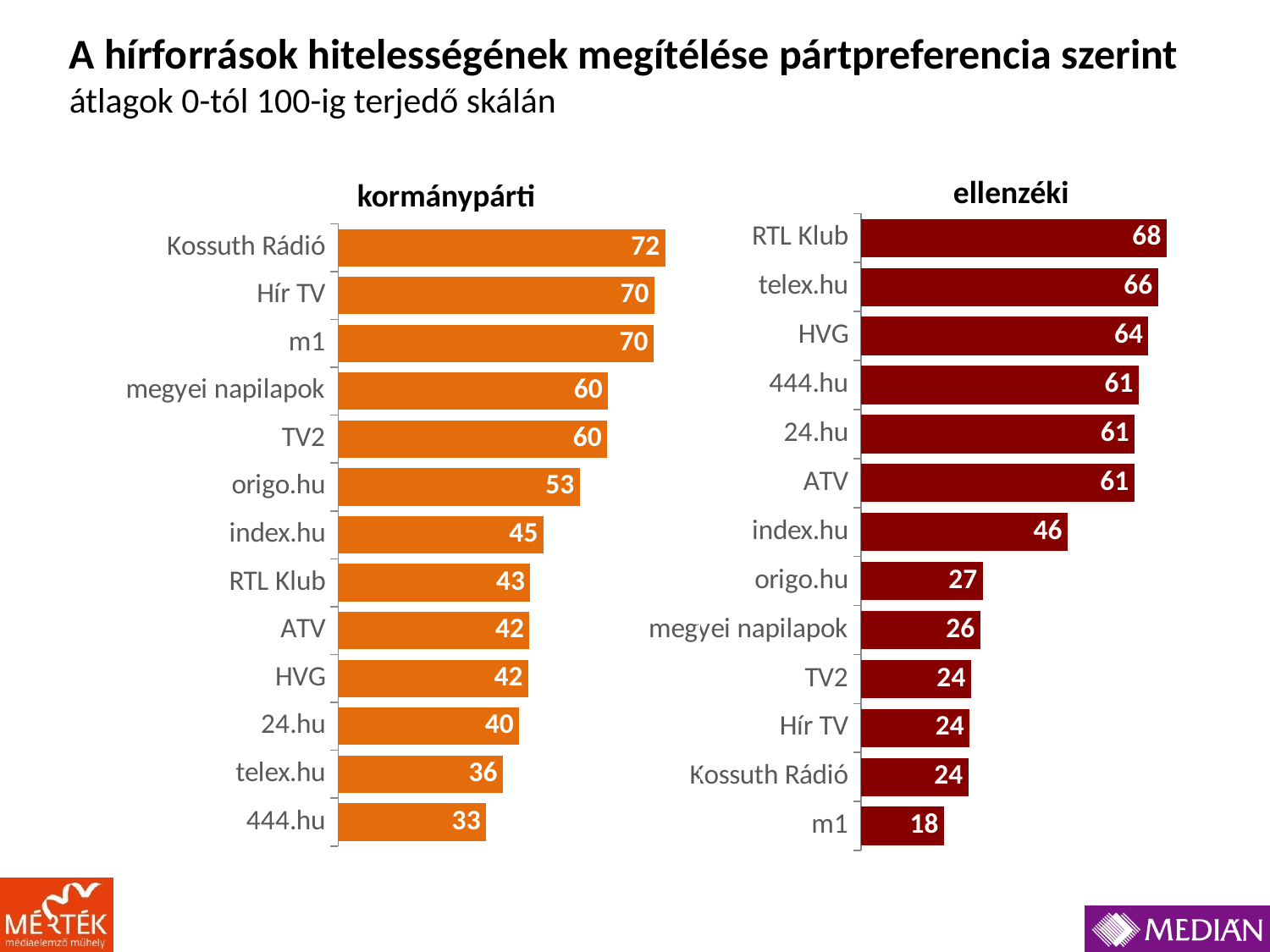
In the 'kormánypárti' chart, which news source has the lowest value? 444.hu What colour are the bars in the 'ellenzéki' chart? dark red Which is larger: the value for telex.hu in the 'kormánypárti' chart or the value for telex.hu in the 'ellenzéki' chart? ellenzéki In the 'kormánypárti' chart, what is the value for Kossuth Rádió? 72 In the 'ellenzéki' chart, what is the value for HVG? 64 What type of chart is the 'kormánypárti' chart? bar chart In the 'ellenzéki' chart, which news source has the highest value? RTL Klub In the 'kormánypárti' chart, which is larger: the value for origo.hu or the value for index.hu? origo.hu In the 'kormánypárti' chart, what is the difference between the values for Kossuth Rádió and 444.hu? 39 In the 'ellenzéki' chart, what is the difference between the values for RTL Klub and index.hu? 22 In the 'ellenzéki' chart, which news source has the lowest value? m1 How many news sources are shown in the 'ellenzéki' chart? 13